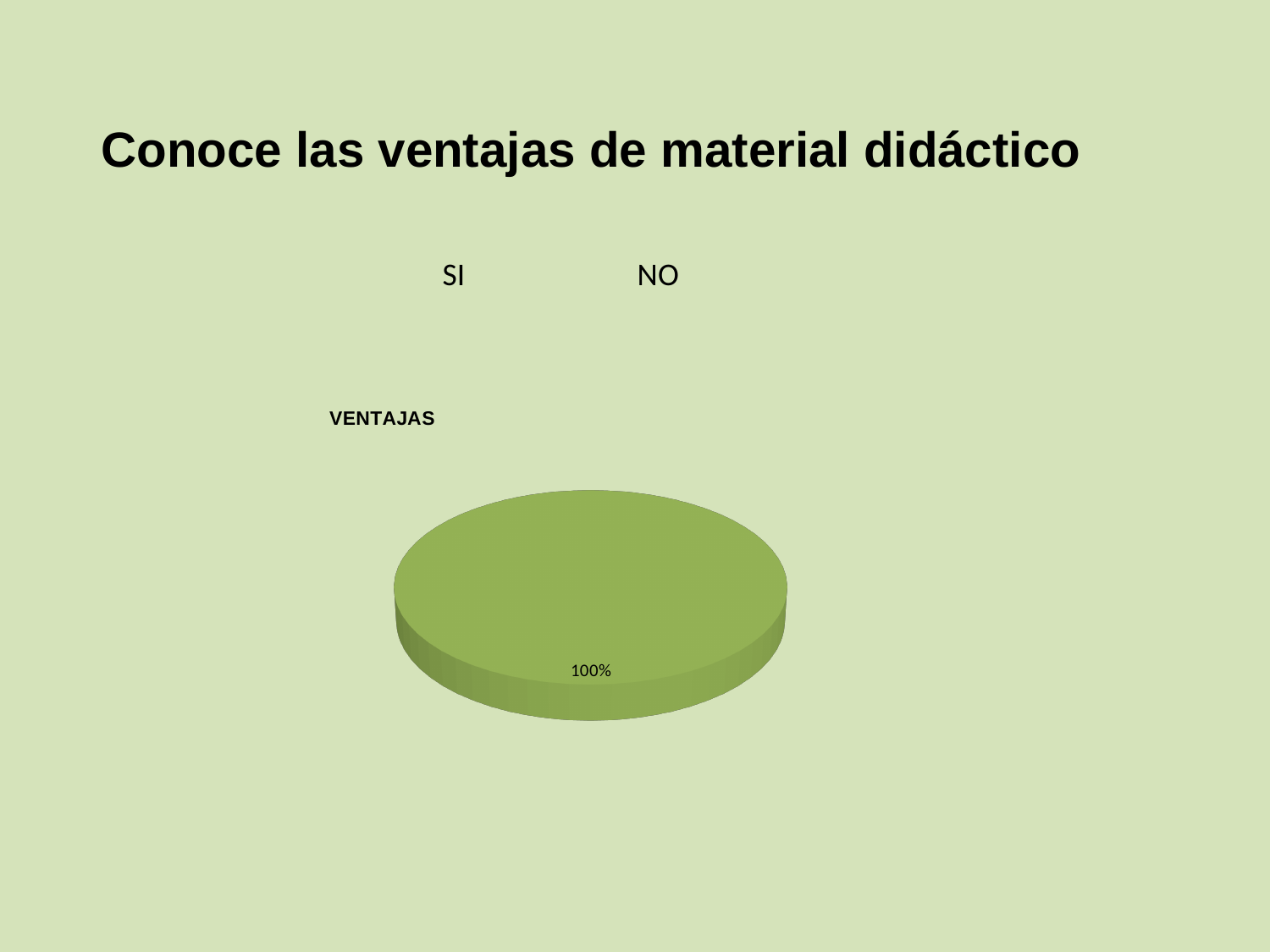
What percentage is printed on the single visible slice of the pie chart? 100% What is the title of the chart? VENTAJAS How many slices are visible in the pie chart? 1 What kind of chart is shown on the slide? pie chart Is the share shown on the visible pie slice greater or less than 50%? greater